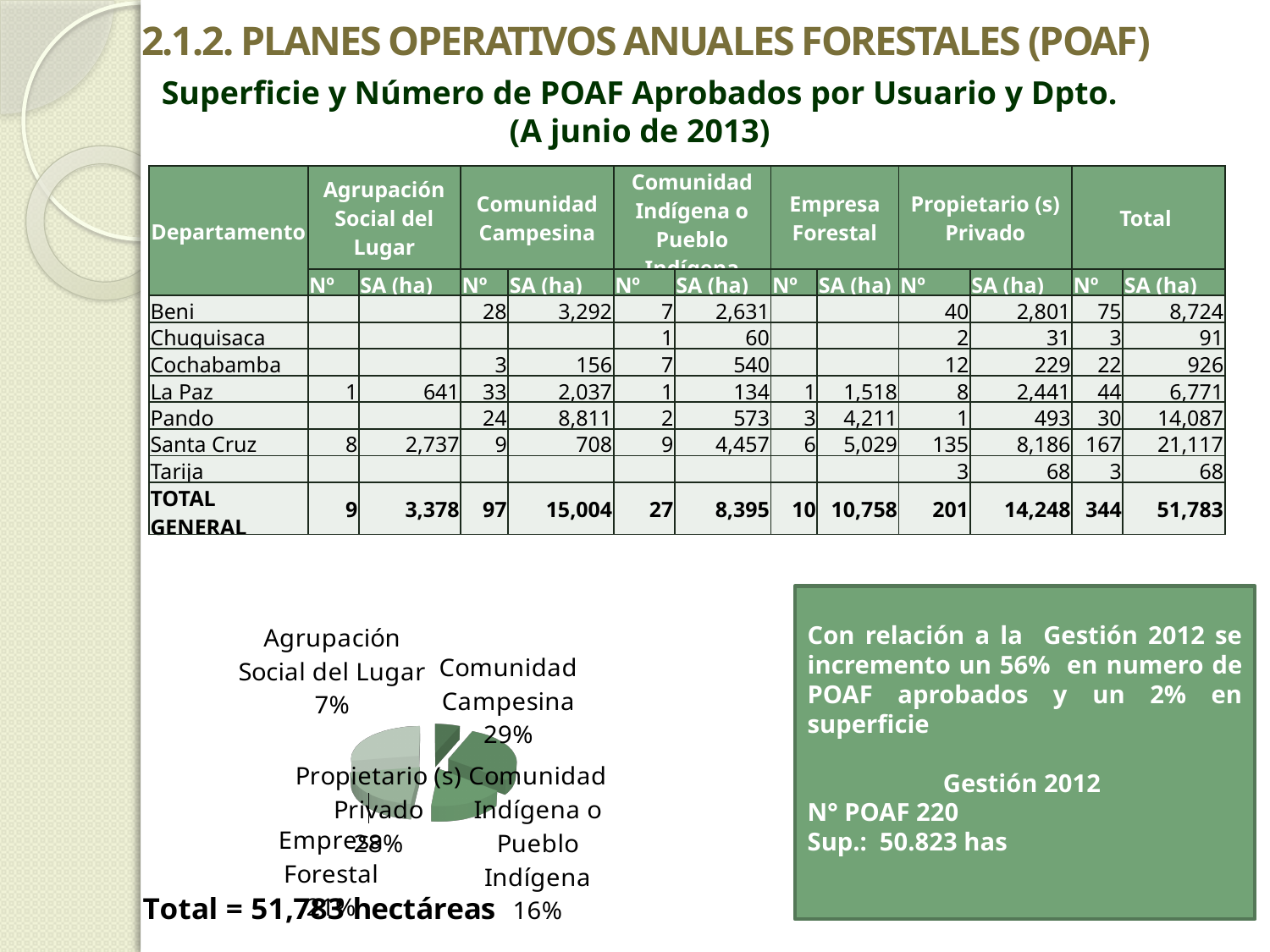
What kind of chart is shown at the bottom left of the slide? Pie chart What total in hectares is stated below the pie chart? 51,783 hectáreas Which slice is larger in the pie chart, Comunidad Campesina or Comunidad Indígena o Pueblo Indígena? Comunidad Campesina Which category has the smallest slice in the pie chart? Agrupación Social del Lugar What share of the pie does Agrupación Social del Lugar represent? 7% What share of the pie does Comunidad Indígena o Pueblo Indígena represent? 16% Which slice is larger in the pie chart, Agrupación Social del Lugar or Comunidad Indígena o Pueblo Indígena? Comunidad Indígena o Pueblo Indígena How many slices does the pie chart have? 5 By how many percentage points does the Comunidad Campesina share exceed the Comunidad Indígena o Pueblo Indígena share in the pie chart? 13 percentage points What share of the pie does Comunidad Campesina represent? 29%